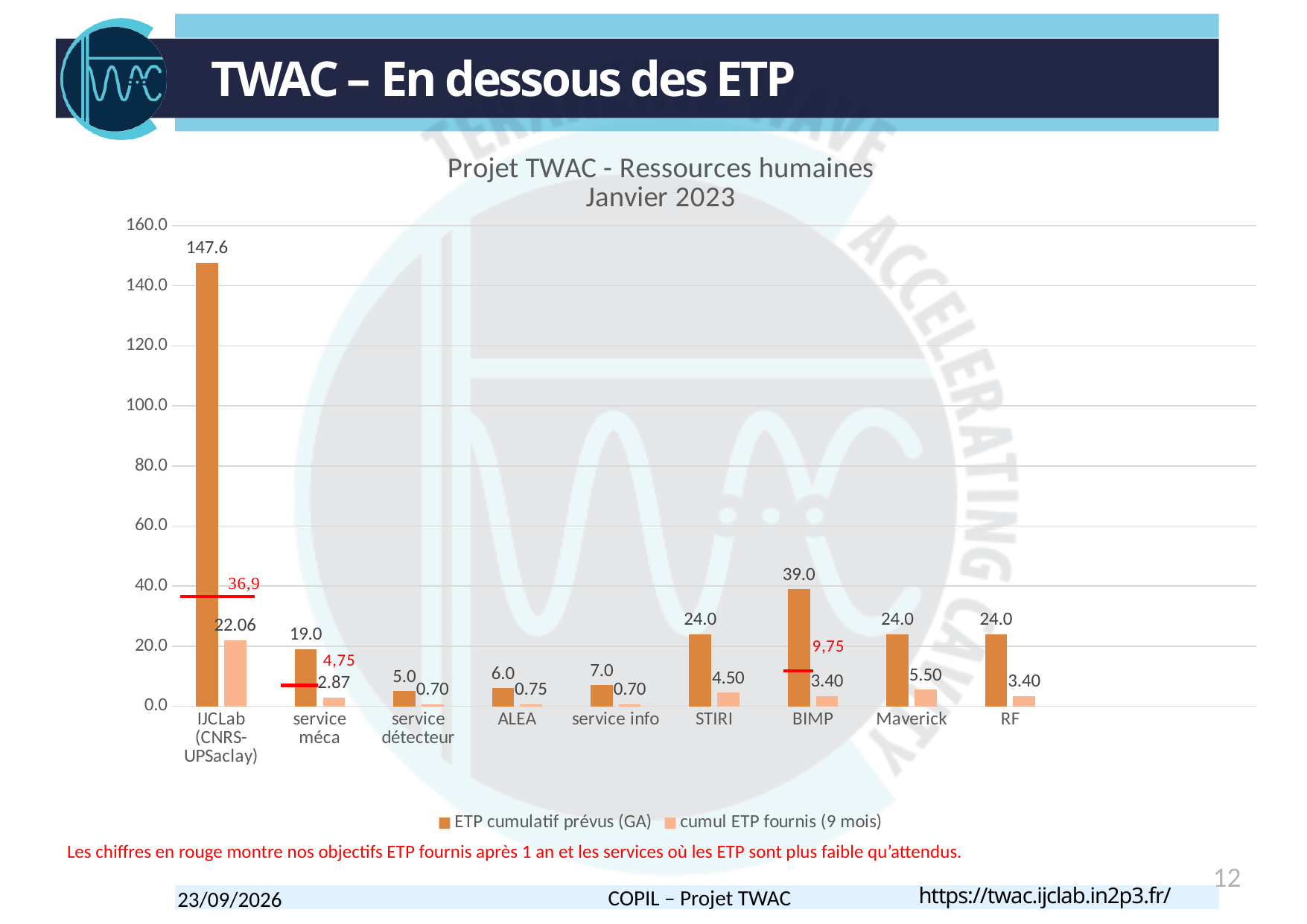
Which category has the lowest 'ETP cumulatif prévus (GA)' value? service détecteur Which category has the highest 'ETP cumulatif prévus (GA)' value? IJCLab (CNRS-UPSaclay) What is the difference between the 'ETP cumulatif prévus (GA)' and 'cumul ETP fournis (9 mois)' values for BIMP? 35.6 What red target figure is shown above the bars for service méca? 4,75 How many categories are shown on the x axis of the chart? 9 Which is larger: the 'cumul ETP fournis (9 mois)' value for STIRI or for Maverick? Maverick What is the value of 'cumul ETP fournis (9 mois)' for BIMP? 3.40 How many series does the legend list? 2 Is the 'ETP cumulatif prévus (GA)' value for IJCLab (CNRS-UPSaclay) greater or less than 140.0? greater What is the value of 'cumul ETP fournis (9 mois)' for Maverick? 5.50 What is the value of 'ETP cumulatif prévus (GA)' for IJCLab (CNRS-UPSaclay)? 147.6 What kind of chart is shown on the slide? Bar chart